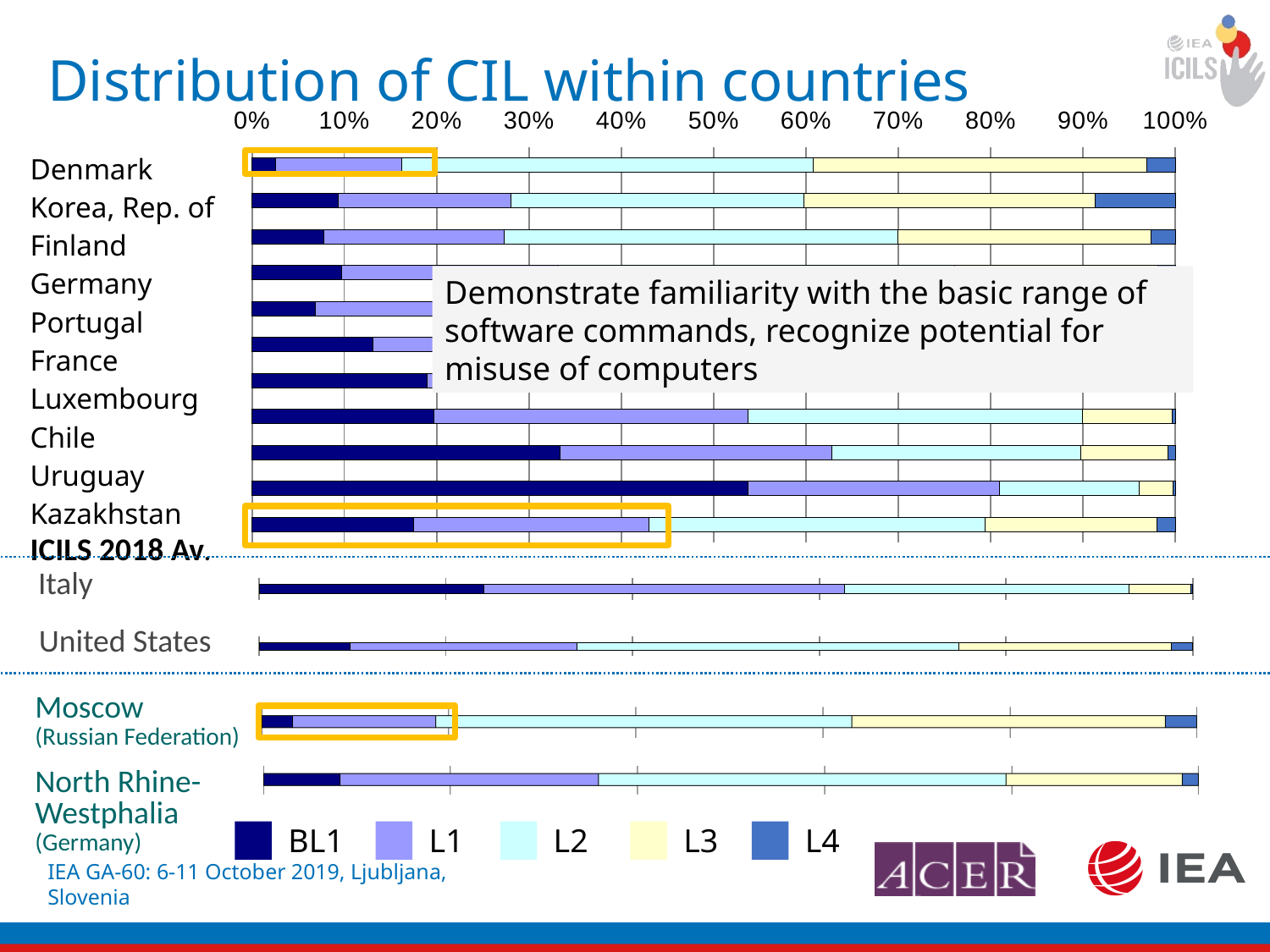
Is the BL1 share for Moscow (Russian Federation) greater or less than 10%? less Is the BL1 share for Uruguay greater or less than 30%? greater Which has the larger BL1 share, Uruguay or Chile? Uruguay Is the BL1 share for Denmark greater or less than 10%? less What is the title of the chart? Distribution of CIL within countries Which legend entry is listed last? L4 What kind of chart is shown on the slide? bar chart How many series does the legend list? 5 Which country has the largest BL1 share? Kazakhstan How many countries or regions (including the ICILS 2018 average) have bars in the chart? 15